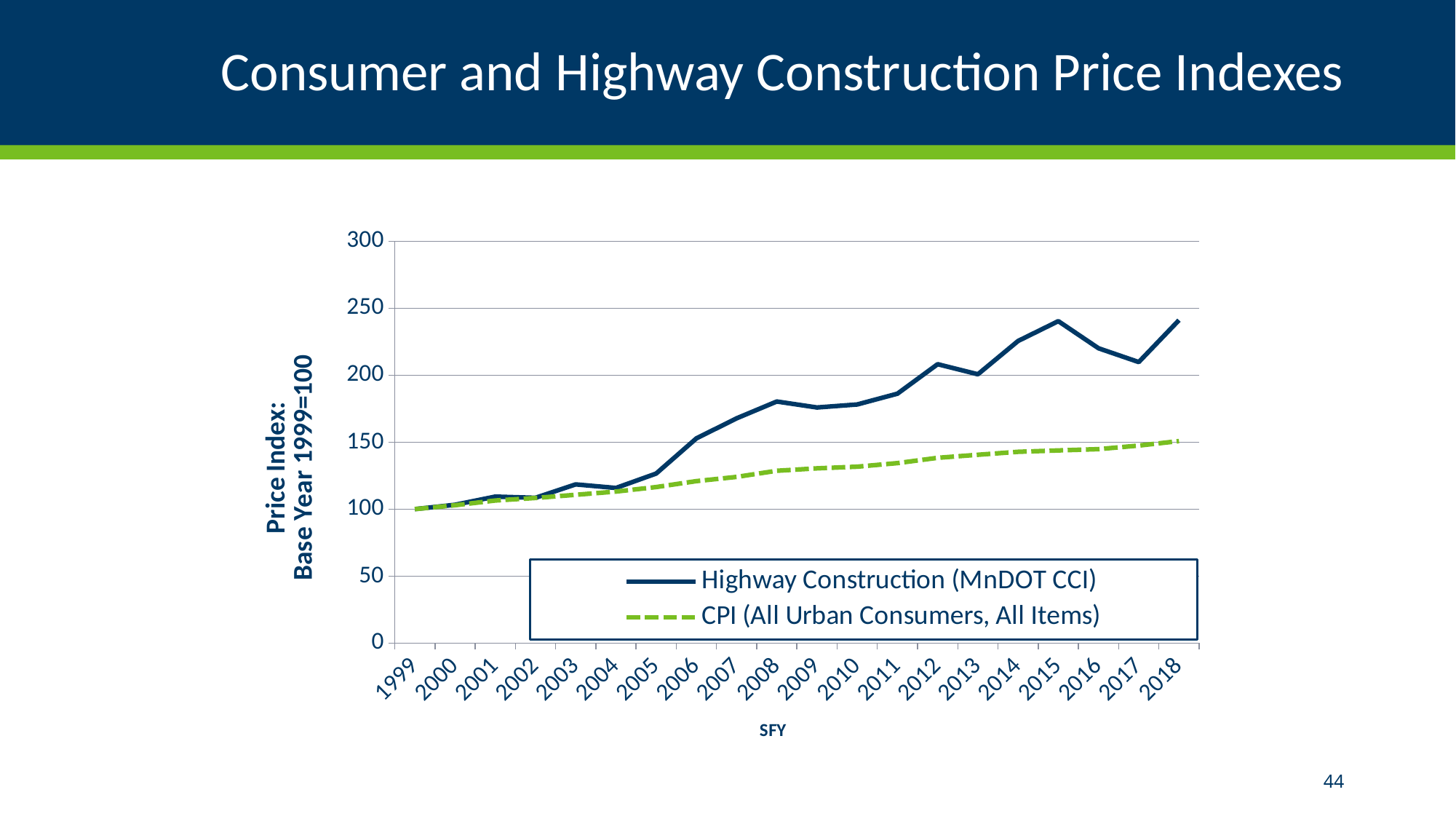
Does the CPI (All Urban Consumers, All Items) line generally rise or fall from 1999 to 2018? rise Is the value for CPI (All Urban Consumers, All Items) in 2018 greater or less than 200? less What kind of chart is shown on the slide? line chart What is the value of the Highway Construction (MnDOT CCI) index in 1999? 100 What is the label on the x axis of the chart? SFY Is the value for Highway Construction (MnDOT CCI) in 2018 greater or less than 200? greater What is the value of the CPI (All Urban Consumers, All Items) index in 1999? 100 How many years are plotted along the x axis? 20 Is the value for CPI (All Urban Consumers, All Items) in 2005 greater or less than 150? less In 2018, which series has the higher value: Highway Construction (MnDOT CCI) or CPI (All Urban Consumers, All Items)? Highway Construction (MnDOT CCI) How many series does the legend list? 2